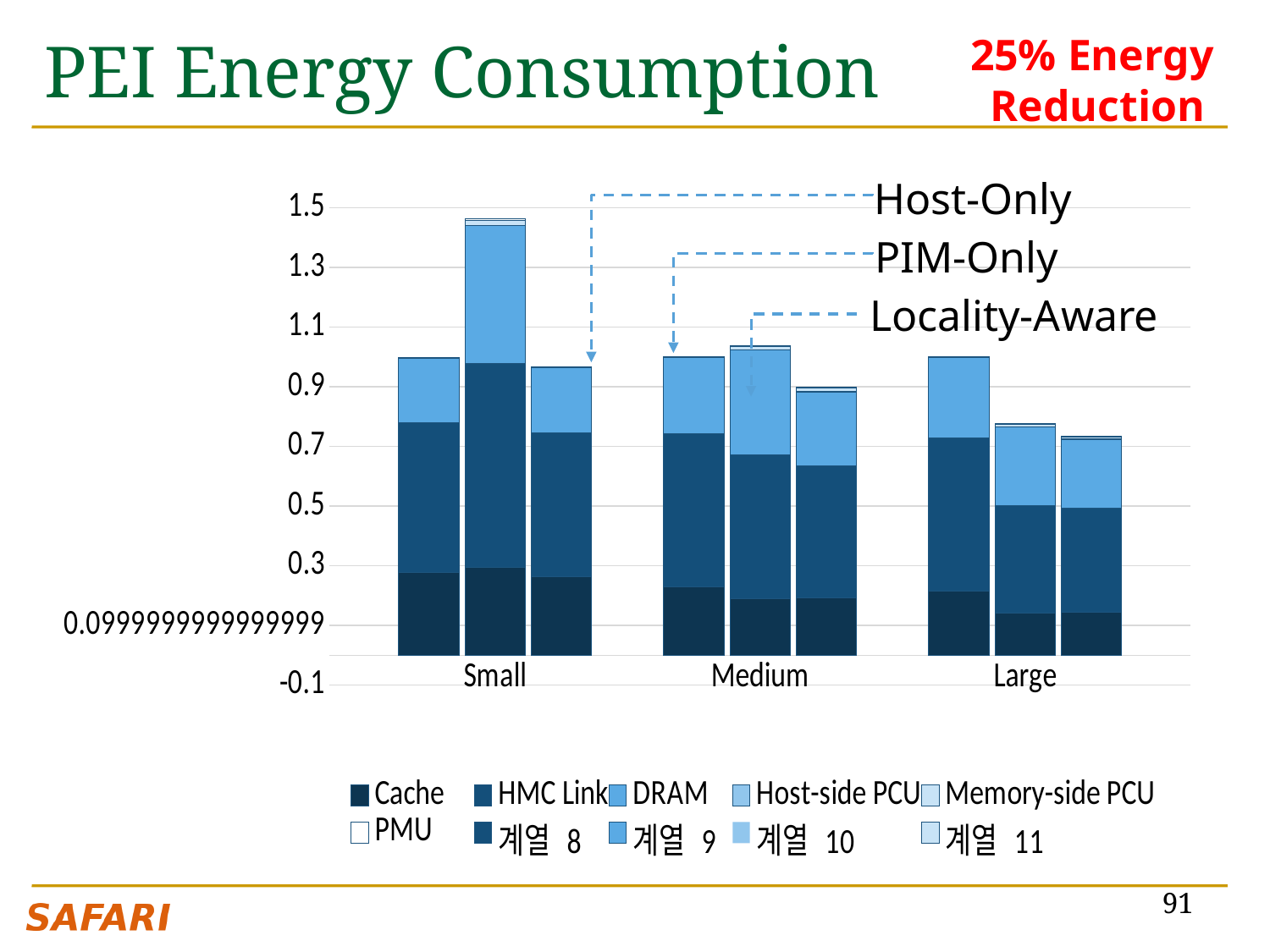
What type of chart is shown on the slide? Stacked bar chart Is the total for the PIM-Only bar in the Small group greater or less than 1.3? greater What is the title of the chart? PEI Energy Consumption How many workload size categories are shown on the x axis? 3 Which bar has the highest total energy consumption in the chart? PIM-Only for Small Is the total for the Locality-Aware bar in the Large group greater or less than 0.9? less How many series does the legend list? 10 In the Medium group, which bar is taller: PIM-Only or Locality-Aware? PIM-Only Is the total for the PIM-Only bar in the Medium group greater or less than 0.9? greater Do the Locality-Aware bar totals rise or fall from Small to Large? fall In the Small group, which bar is taller: Host-Only or PIM-Only? PIM-Only What energy reduction is highlighted in red at the top right of the slide? 25% Energy Reduction